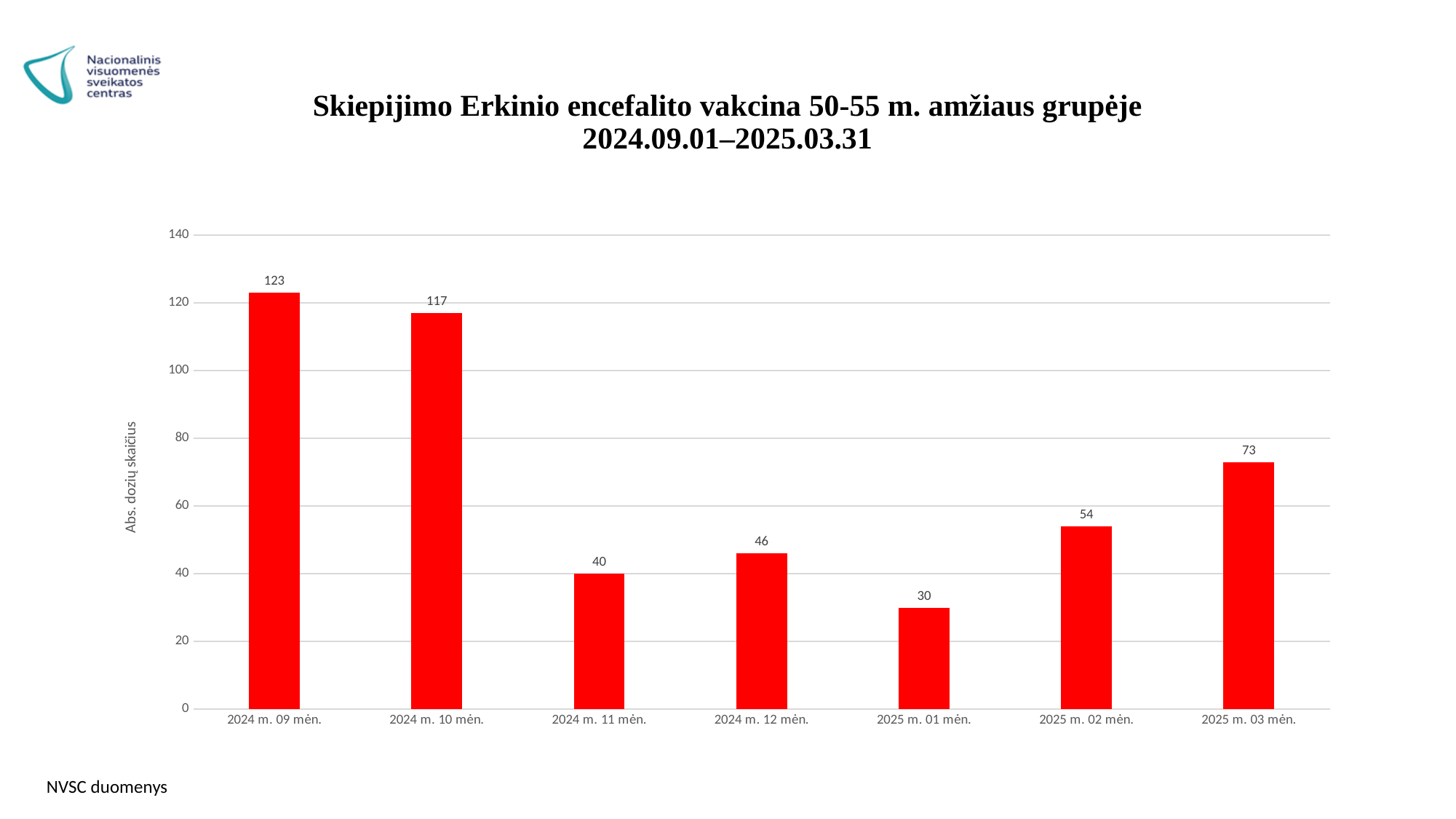
Is the value for 2024 m. 10 mėn. greater or less than 100? greater What kind of chart is shown on the slide? bar chart What is the value for 2025 m. 01 mėn.? 30 What is the value for 2024 m. 09 mėn.? 123 How many months are shown on the x axis? 7 What is the value for 2025 m. 03 mėn.? 73 What is the label of the y axis? Abs. dozių skaičius Which month has the lowest value? 2025 m. 01 mėn. What is the difference between the values for 2025 m. 03 mėn. and 2025 m. 02 mėn.? 19 What is the difference between the values for 2024 m. 09 mėn. and 2024 m. 10 mėn.? 6 Which month has the highest value? 2024 m. 09 mėn. Which is larger, the value for 2024 m. 12 mėn. or 2024 m. 11 mėn.? 2024 m. 12 mėn.